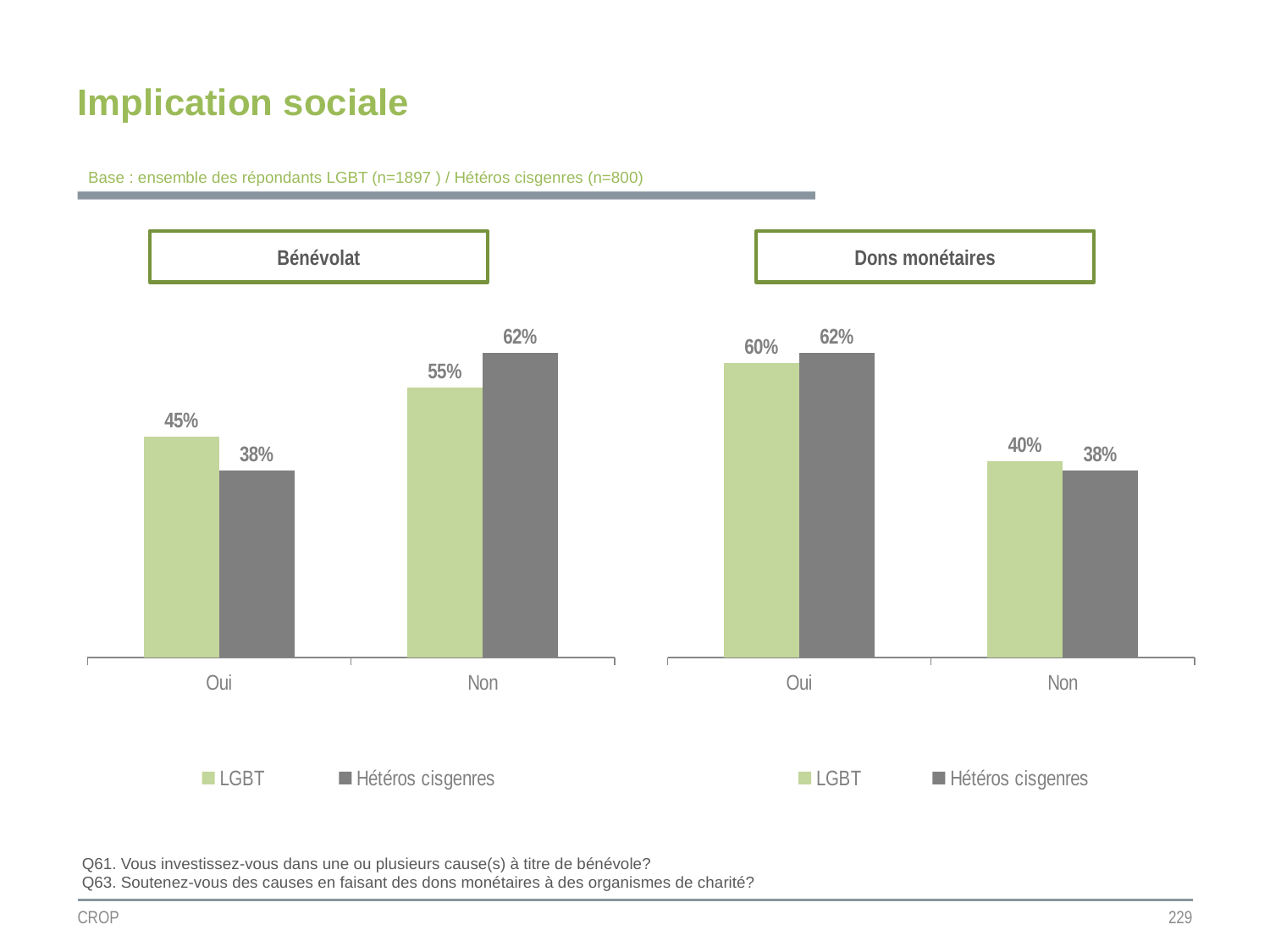
In the Bénévolat chart, which is larger in the Oui category: LGBT or Hétéros cisgenres? LGBT In the Bénévolat chart, which bar has the lowest value? Hétéros cisgenres, Oui (38%) What type of chart is the Dons monétaires chart? Bar chart How many categories are shown on the x axis of the Bénévolat chart? 2 In the Bénévolat chart, what is the value for LGBT in the Oui category? 45% How many series does the legend of the Dons monétaires chart list? 2 In the Bénévolat chart, what is the difference between the Hétéros cisgenres and LGBT values in the Non category? 7 percentage points In the Dons monétaires chart, what is the value for LGBT in the Oui category? 60% In the Dons monétaires chart, which category has the highest Hétéros cisgenres value? Oui In the Bénévolat chart, what is the value for Hétéros cisgenres in the Non category? 62% In the Dons monétaires chart, what is the difference between the LGBT values for Oui and Non? 20 percentage points In the Dons monétaires chart, what is the value for Hétéros cisgenres in the Non category? 38%